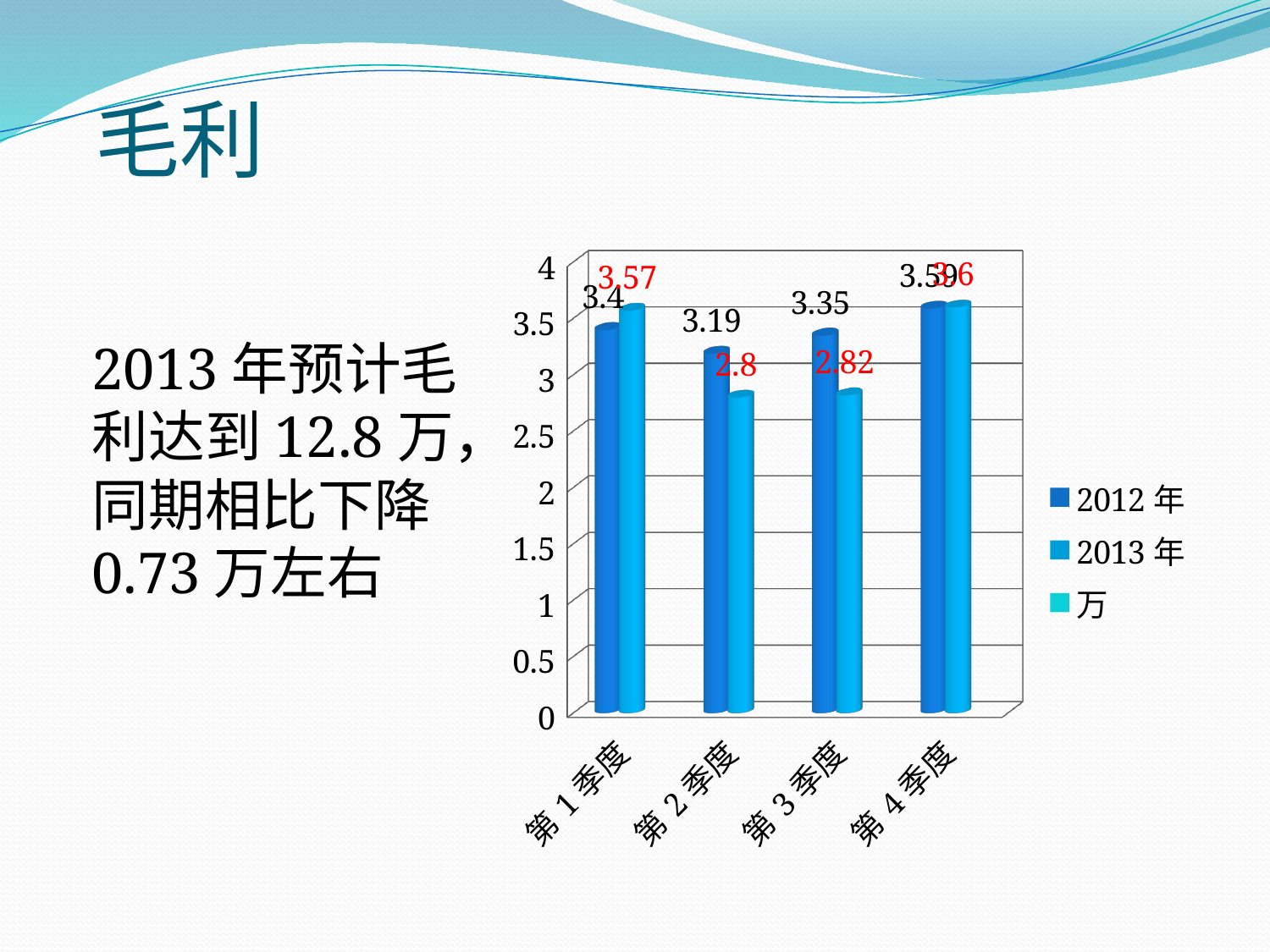
What is the value for 2012 年 in 第 2 季度? 3.19 What is the difference between the 2012 年 and 2013 年 values in 第 2 季度? 0.39 What is the value for 2013 年 in 第 1 季度? 3.57 Is the value for 2012 年 in 第 4 季度 greater or less than 3? greater What is the value for 2013 年 in 第 2 季度? 2.8 In 第 1 季度, which is larger: the 2012 年 value or the 2013 年 value? 2013 年 What is the value for 2013 年 in 第 3 季度? 2.82 How many quarters are shown on the x axis? 4 Which quarter has the lowest value for 2013 年? 第 2 季度 How many entries does the legend list? 3 What is the value for 2012 年 in 第 3 季度? 3.35 What is the value for 2012 年 in 第 1 季度? 3.4